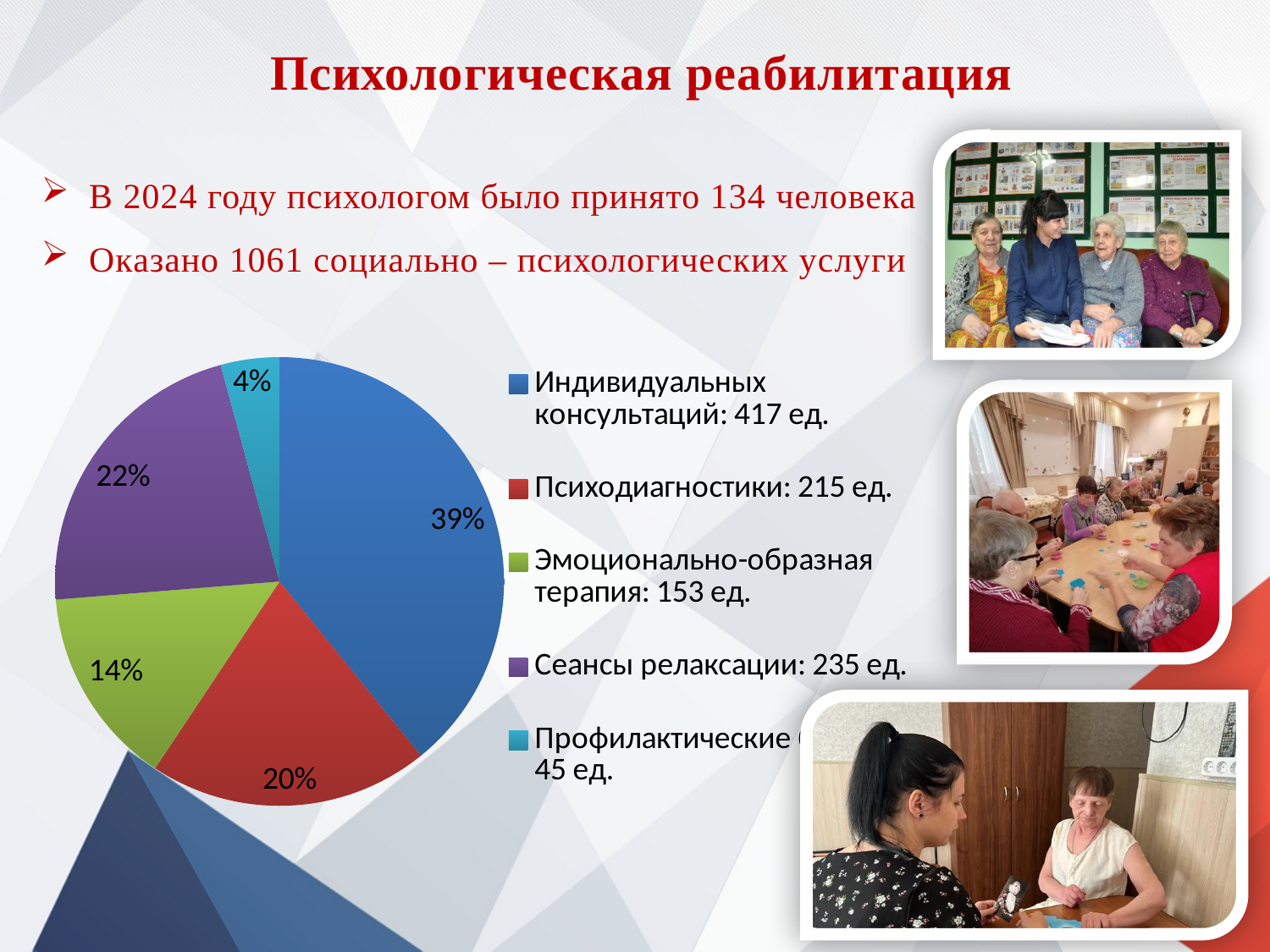
Which slice is larger: Сеансы релаксации or Психодиагностики? Сеансы релаксации What is the smallest percentage labelled on the pie chart? 4% What percentage of the pie chart is Эмоционально-образная терапия? 14% How many slices does the pie chart have? 5 What colour is the Психодиагностики slice in the pie chart? red What percentage of the pie chart is Психодиагностики? 20% What percentage of the pie chart is Индивидуальных консультаций? 39% According to the legend, how many units (ед.) are listed for Сеансы релаксации? 235 ед. By how many percentage points does the Индивидуальных консультаций slice exceed the Психодиагностики slice? 19 percentage points What kind of chart is shown on the slide? pie chart Which category has the largest slice of the pie chart? Индивидуальных консультаций What percentage of the pie chart is Сеансы релаксации? 22%